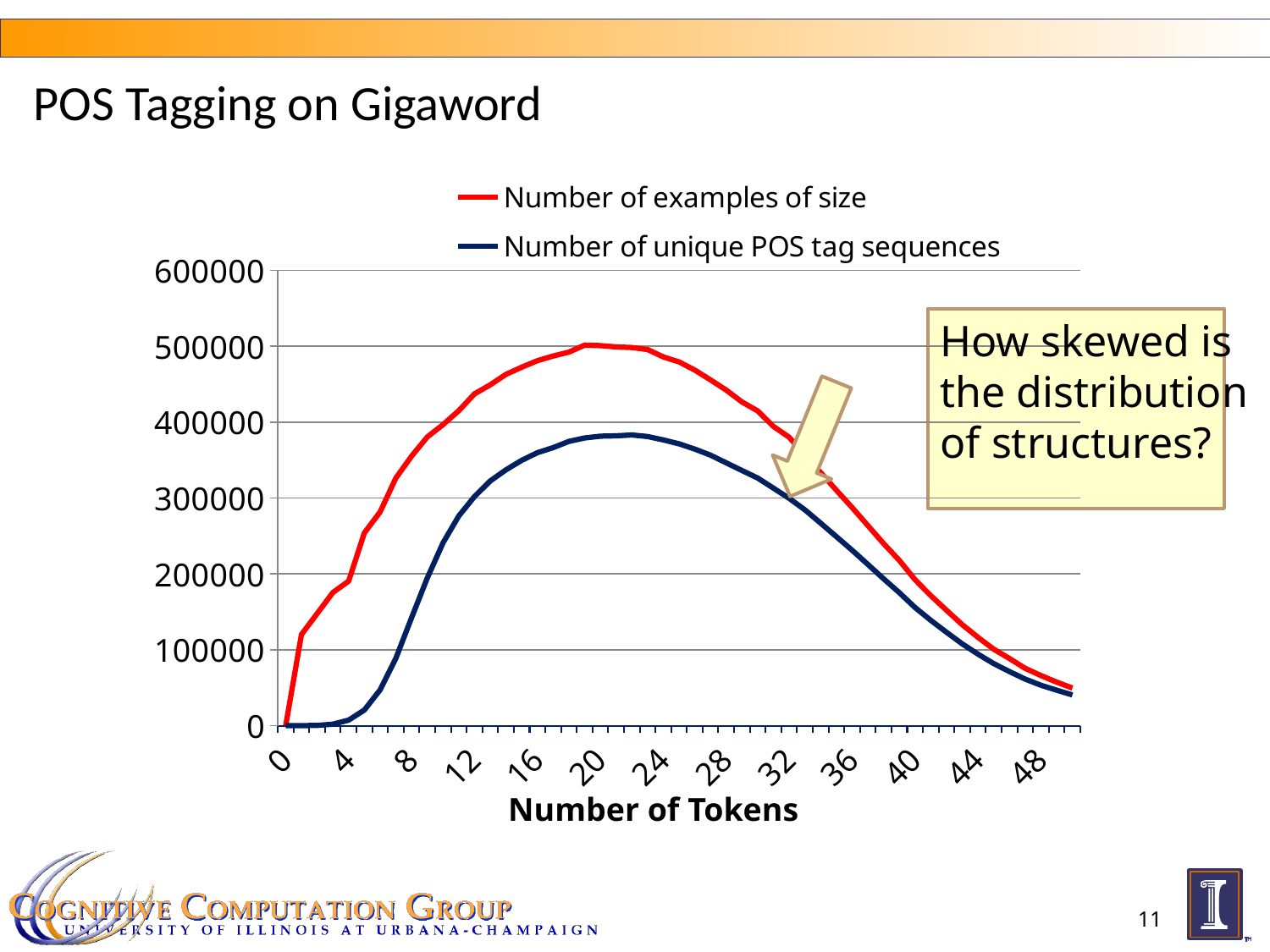
Does the 'Number of examples of size' series rise or fall as the number of tokens increases from 24 to 48? fall What is the title of the x axis? Number of Tokens What kind of chart is shown on the slide? line chart Is the value of 'Number of examples of size' at 48 tokens greater or less than 100000? less Is the value of 'Number of unique POS tag sequences' at 4 tokens greater or less than 100000? less How many series does the legend list? 2 Is the value of 'Number of examples of size' at 20 tokens greater or less than 400000? greater At 20 tokens, which series has the larger value: 'Number of examples of size' or 'Number of unique POS tag sequences'? Number of examples of size Does the 'Number of unique POS tag sequences' series rise or fall as the number of tokens increases from 4 to 16? rise What are the two series named in the legend? Number of examples of size; Number of unique POS tag sequences